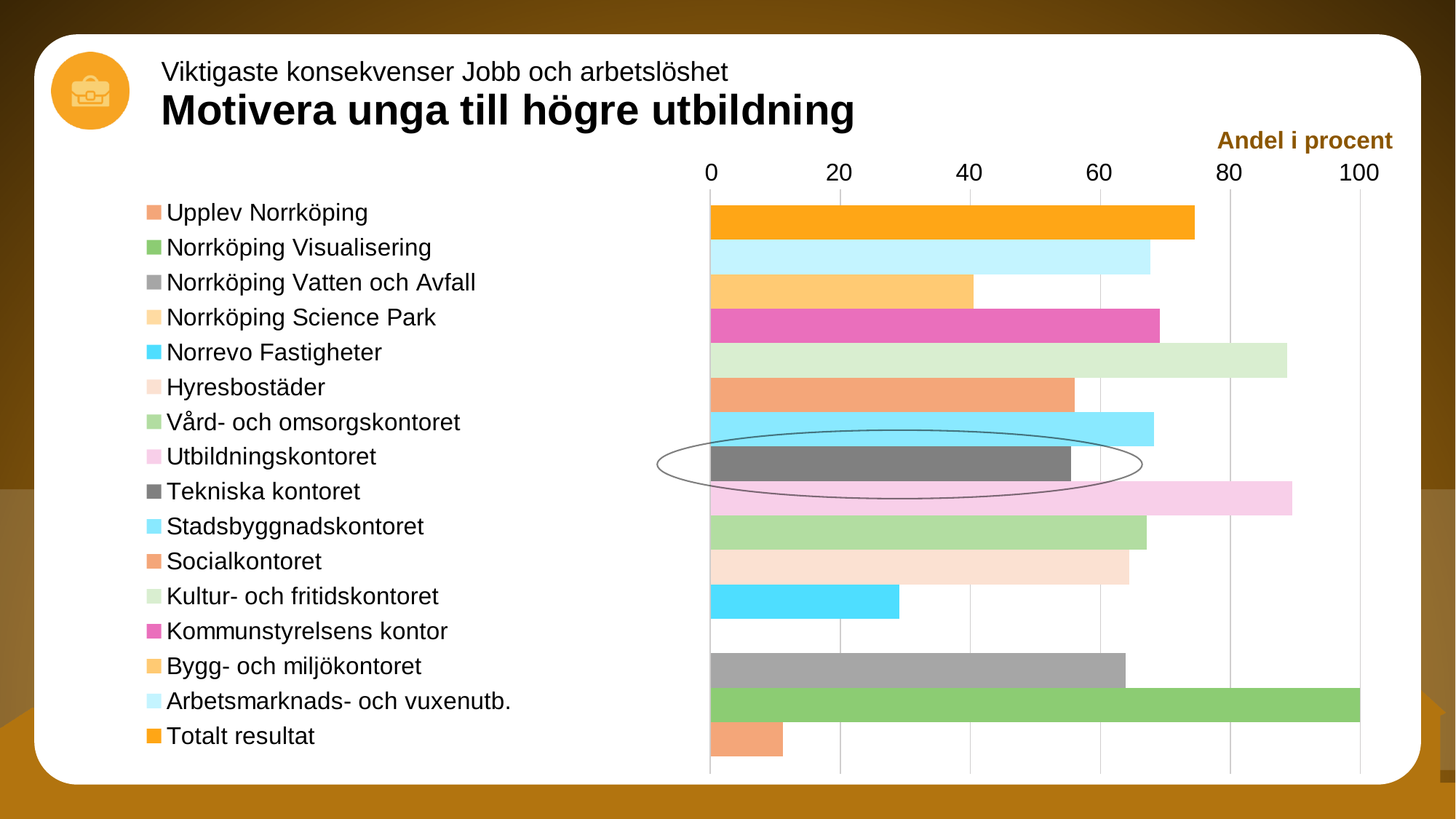
Which category has the highest value? Norrköping Visualisering What label is shown above the horizontal axis of the chart? Andel i procent What is the value for Norrköping Visualisering? 100 Is the value for Kultur- och fritidskontoret greater or less than 80? greater Which is larger, the value for Hyresbostäder or the value for Norrevo Fastigheter? Hyresbostäder Is the value for Upplev Norrköping greater or less than 20? less Is the value for Totalt resultat greater or less than 60? greater What kind of chart is shown on the slide? bar chart Which is larger, the value for Kultur- och fritidskontoret or the value for Socialkontoret? Kultur- och fritidskontoret How many entries does the legend list? 16